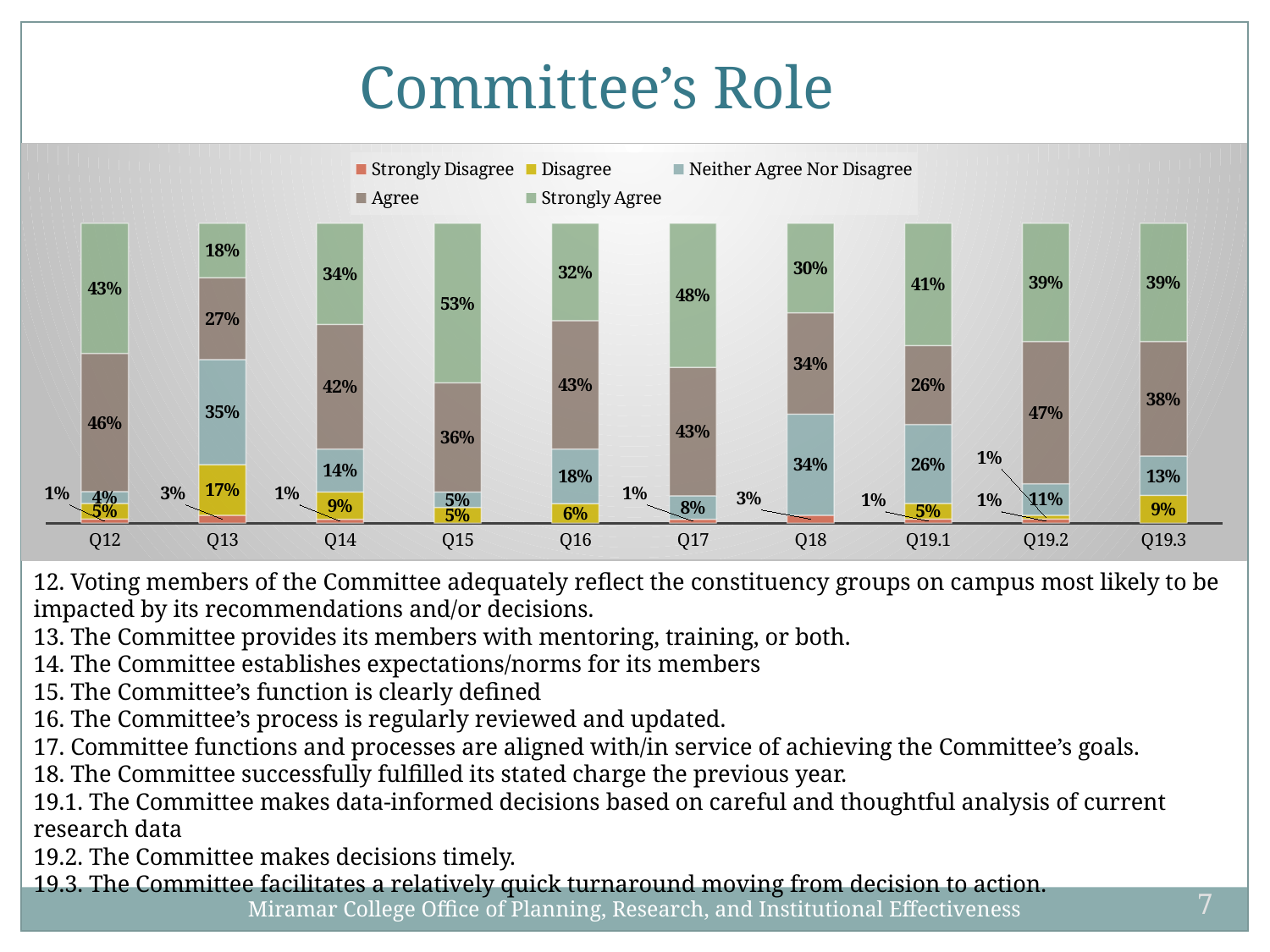
What is the difference between the Agree values for Q12 and Q13? 19% What is the Agree value for Q19.2? 47% What is the Neither Agree Nor Disagree value for Q13? 35% How many questions (categories) are shown on the x axis? 10 How many series does the legend list? 5 What type of chart is shown on the slide? Stacked bar chart What is the Disagree value for Q19.3? 9% Which is larger, the Neither Agree Nor Disagree value for Q18 or for Q16? Q18 What is the title of the slide containing the chart? Committee's Role What percentage of respondents selected Strongly Agree for Q15? 53% Which question has the lowest Strongly Agree percentage? Q13 Which question has the highest Strongly Agree percentage? Q15